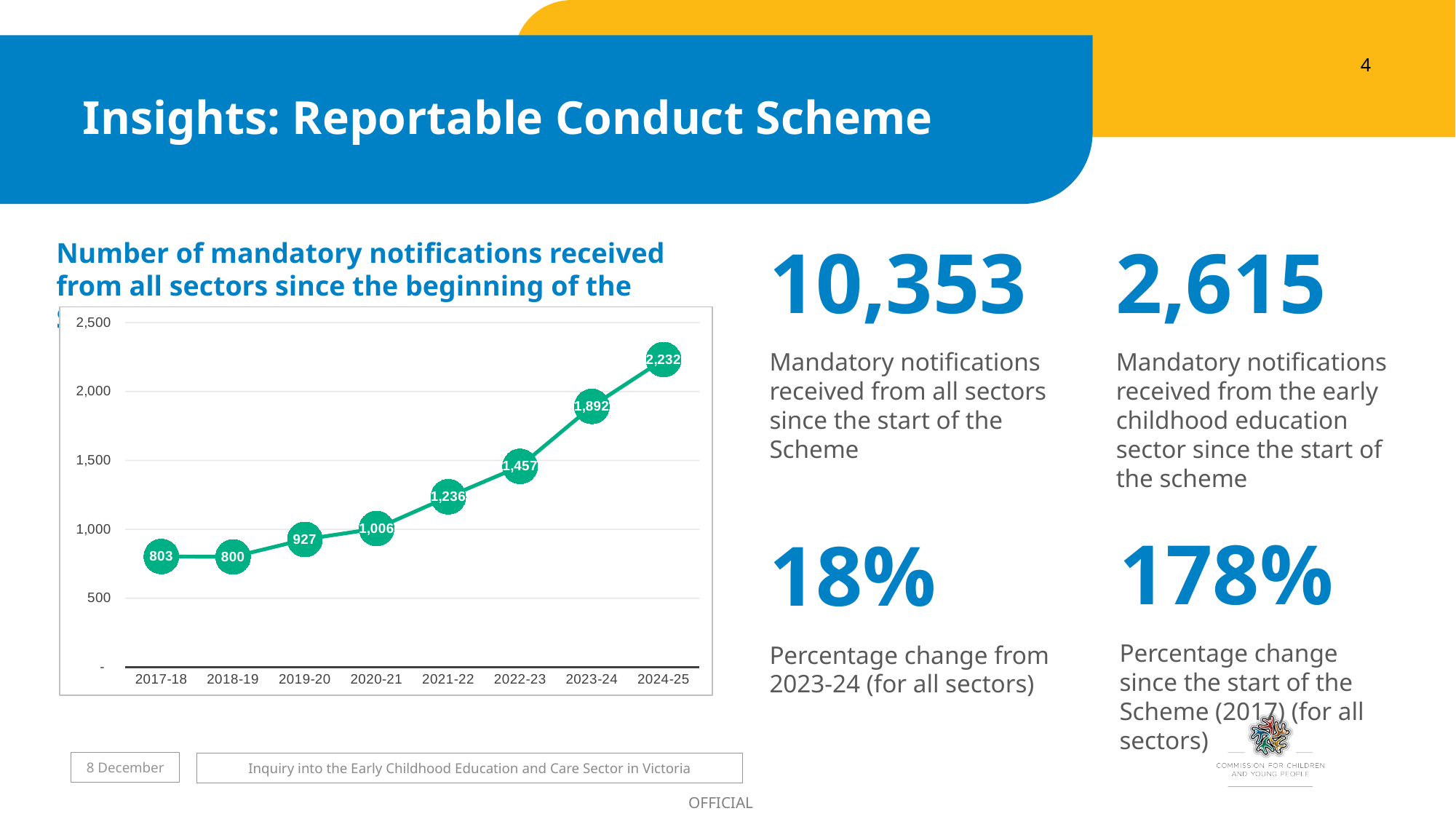
What kind of chart is shown on the slide? line chart What is the number of mandatory notifications for 2017-18? 803 How many years are plotted on the chart? 8 Which year has the highest number of mandatory notifications? 2024-25 Which is larger, the value for 2019-20 or the value for 2020-21? 2020-21 What is the value plotted for 2021-22? 1,236 What is the difference between the values for 2024-25 and 2023-24? 340 Do the values generally rise or fall from 2018-19 to 2024-25? rise What is the number of mandatory notifications for 2024-25? 2,232 Is the value for 2022-23 greater or less than 1,500? less Which year has the lowest number of mandatory notifications? 2018-19 What is the difference between the values for 2017-18 and 2018-19? 3